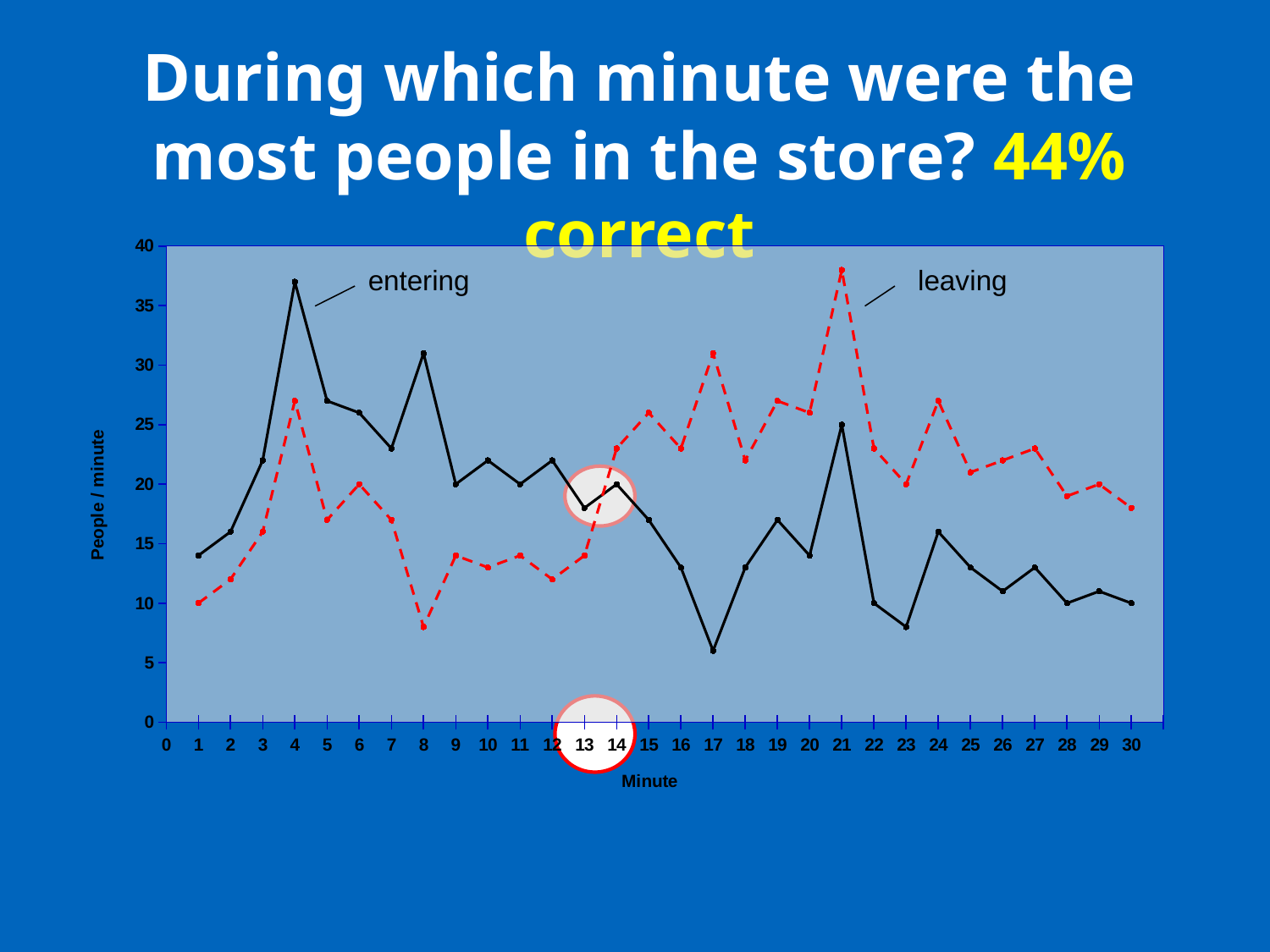
At which minute does the entering series reach its lowest value? 17 At which minute does the leaving series reach its lowest value? 8 What is the label of the vertical axis? People / minute At minute 4, which series has the larger value, entering or leaving? entering What kind of chart is shown on the slide? line chart How many series are plotted on the chart? 2 Is the value for entering at minute 17 greater or less than 10? less At minute 21, which series has the larger value, entering or leaving? leaving What are the two series plotted on the chart? entering and leaving Is the value for entering at minute 4 greater or less than 35? greater At which minute does the leaving series reach its highest value? 21 At which minute does the entering series reach its highest value? 4